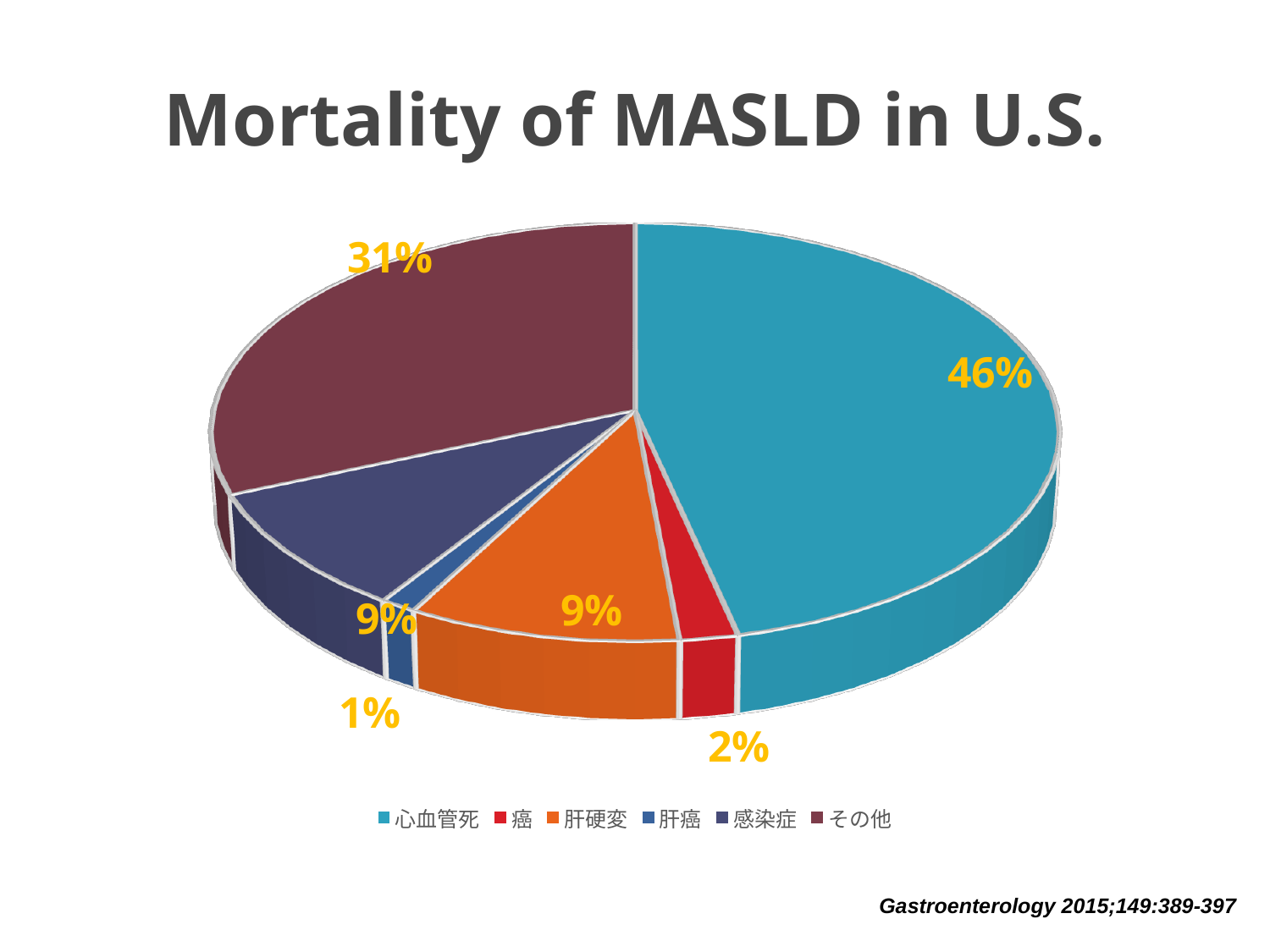
What percentage of the pie is 癌? 2% What is the difference in percentage points between 心血管死 and その他? 15 Which category has the smallest share of the pie? 肝癌 Which is larger, the share for 感染症 or the share for 癌? 感染症 What percentage of the pie is 心血管死? 46% What kind of chart is shown on the slide? Pie chart How many categories does the legend list? 6 What percentage of the pie is 肝癌? 1% What is the title of the chart? Mortality of MASLD in U.S. Which category has the largest share of the pie? 心血管死 What percentage of the pie is その他? 31% What percentage of the pie is 肝硬変? 9%